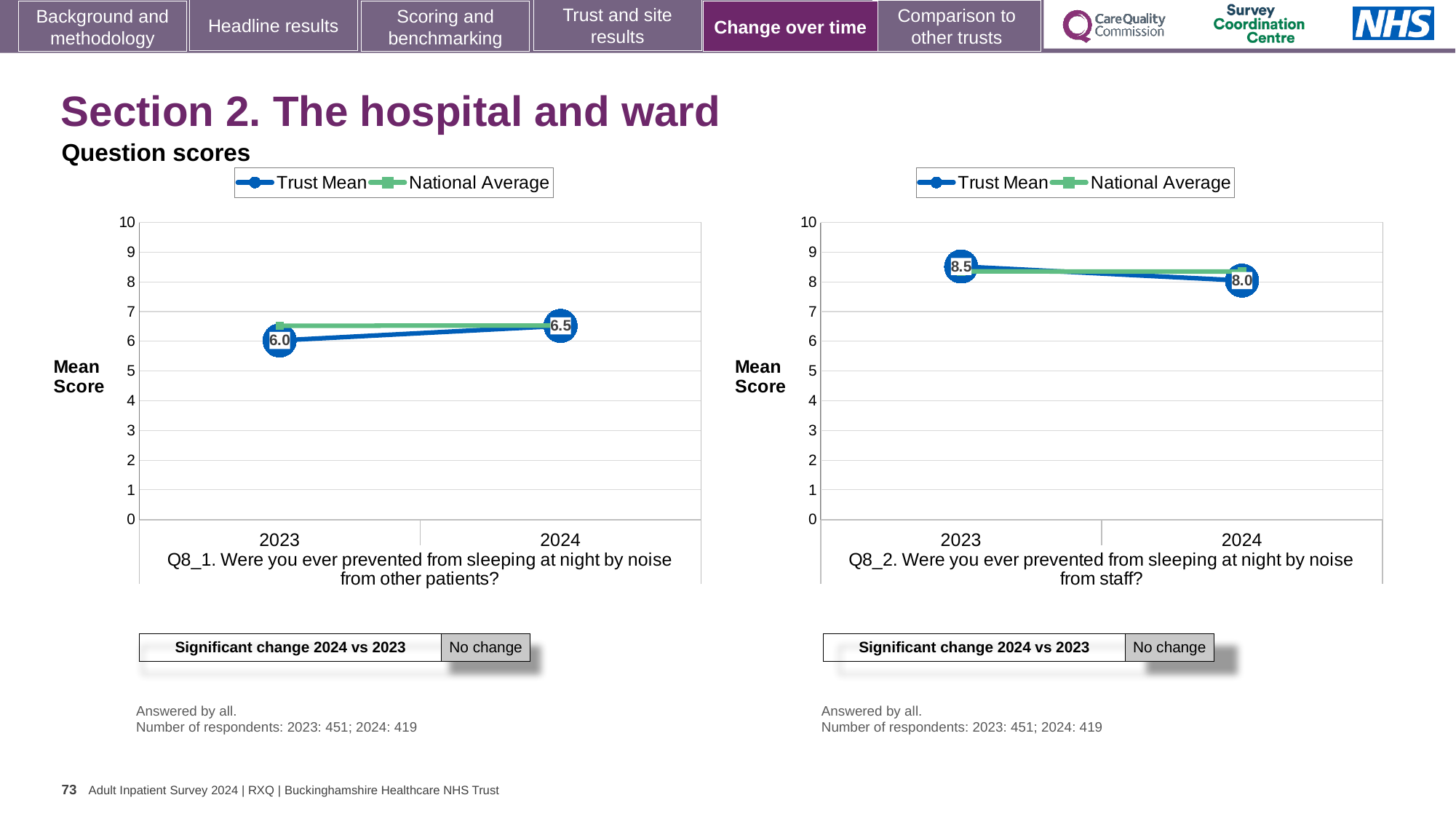
How many series does the legend of the left chart list? 2 On the right chart (Q8_2), does the Trust Mean rise or fall from 2023 to 2024? fall On the left chart (Q8_1), what is the Trust Mean score for 2024? 6.5 On the left chart (Q8_1), by how much did the Trust Mean change from 2023 to 2024? 0.5 On the right chart (Q8_2), what is the difference between the Trust Mean in 2023 and 2024? 0.5 What type of chart is used on the right (Q8_2)? line chart On the right chart (Q8_2), what is the Trust Mean score for 2024? 8.0 On the left chart (Q8_1), what is the Trust Mean score for 2023? 6.0 On the right chart (Q8_2), is the National Average for 2023 greater or less than 7? greater On the left chart (Q8_1), which is larger in 2023, the Trust Mean or the National Average? National Average On the right chart (Q8_2), what is the Trust Mean score for 2023? 8.5 On the left chart (Q8_1), does the Trust Mean rise or fall from 2023 to 2024? rise